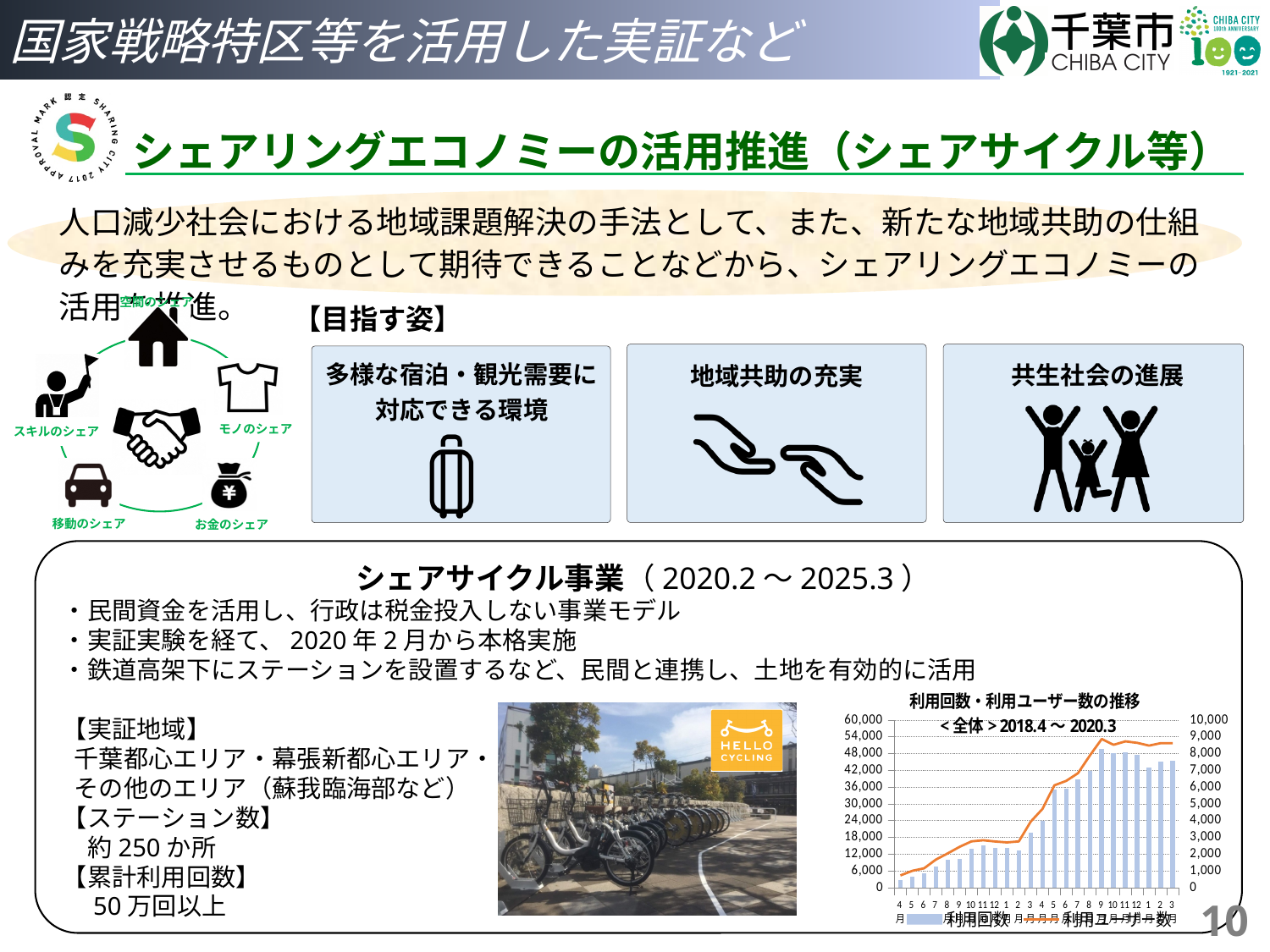
Does the 利用ユーザー数 line generally rise or fall across the period shown in the 利用回数・利用ユーザー数の推移 chart? Rise Which series in the 利用回数・利用ユーザー数の推移 chart is drawn as bars? 利用回数 How many monthly points are plotted along the x axis of the 利用回数・利用ユーザー数の推移 chart? 24 What kind of chart is shown under the title 利用回数・利用ユーザー数の推移? A combined bar and line chart In the 利用回数・利用ユーザー数の推移 chart, is the 利用回数 bar for the last month (March 2020) greater or less than 36,000? greater What period does the subtitle of the 利用回数・利用ユーザー数の推移 chart say the data covers? 2018.4 ～ 2020.3 What is the highest tick value on the left axis of the 利用回数・利用ユーザー数の推移 chart? 60,000 How many series does the legend of the 利用回数・利用ユーザー数の推移 chart list? 2 In the 利用回数・利用ユーザー数の推移 chart, is the 利用回数 bar for the first month (April 2018) greater or less than 6,000? less In the 利用回数・利用ユーザー数の推移 chart, is the 利用回数 bar for the last month (March 2020) greater or less than the bar for the first month (April 2018)? greater Do the 利用回数 bars generally rise or fall from April 2018 to March 2020 in the 利用回数・利用ユーザー数の推移 chart? Rise